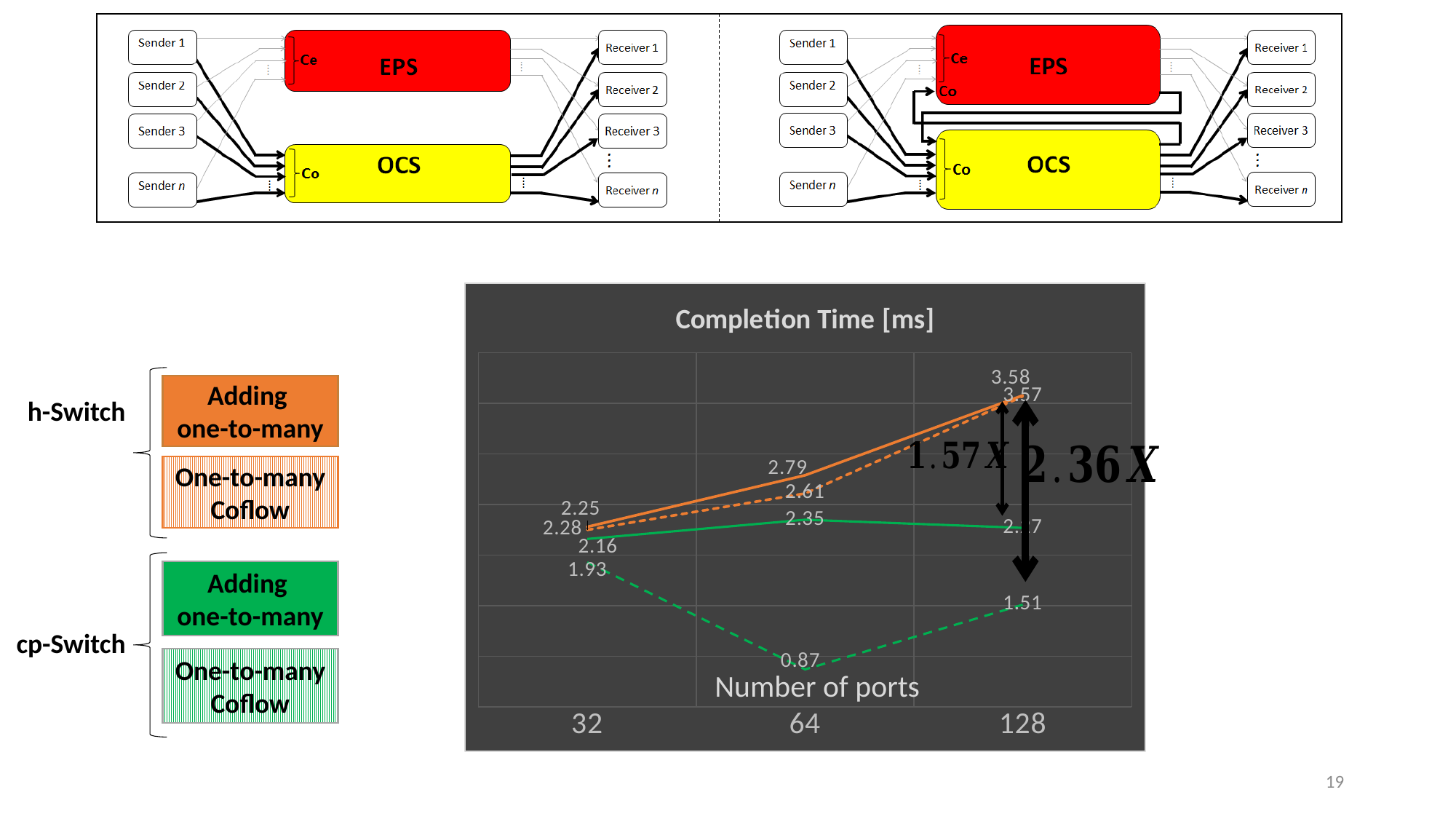
What is the completion time for cp-Switch Adding one-to-many at 64 ports? 2.35 What is the completion time for h-Switch Adding one-to-many at 128 ports? 3.58 What is the completion time for h-Switch One-to-many Coflow at 64 ports? 2.61 What kind of chart is shown on the slide? line chart Which series has the lowest completion time on the chart, and at how many ports? cp-Switch One-to-many Coflow at 64 ports How many port counts are plotted along the x axis of the chart? 3 What is the completion time for cp-Switch One-to-many Coflow at 64 ports? 0.87 What is the completion time for cp-Switch One-to-many Coflow at 128 ports? 1.51 What is the label of the x axis of the chart? Number of ports Does the completion time for h-Switch Adding one-to-many rise or fall as the number of ports increases from 32 to 128? rise What is the title of the chart? Completion Time [ms] At 64 ports, what is the difference in completion time between h-Switch Adding one-to-many and cp-Switch Adding one-to-many? 0.44